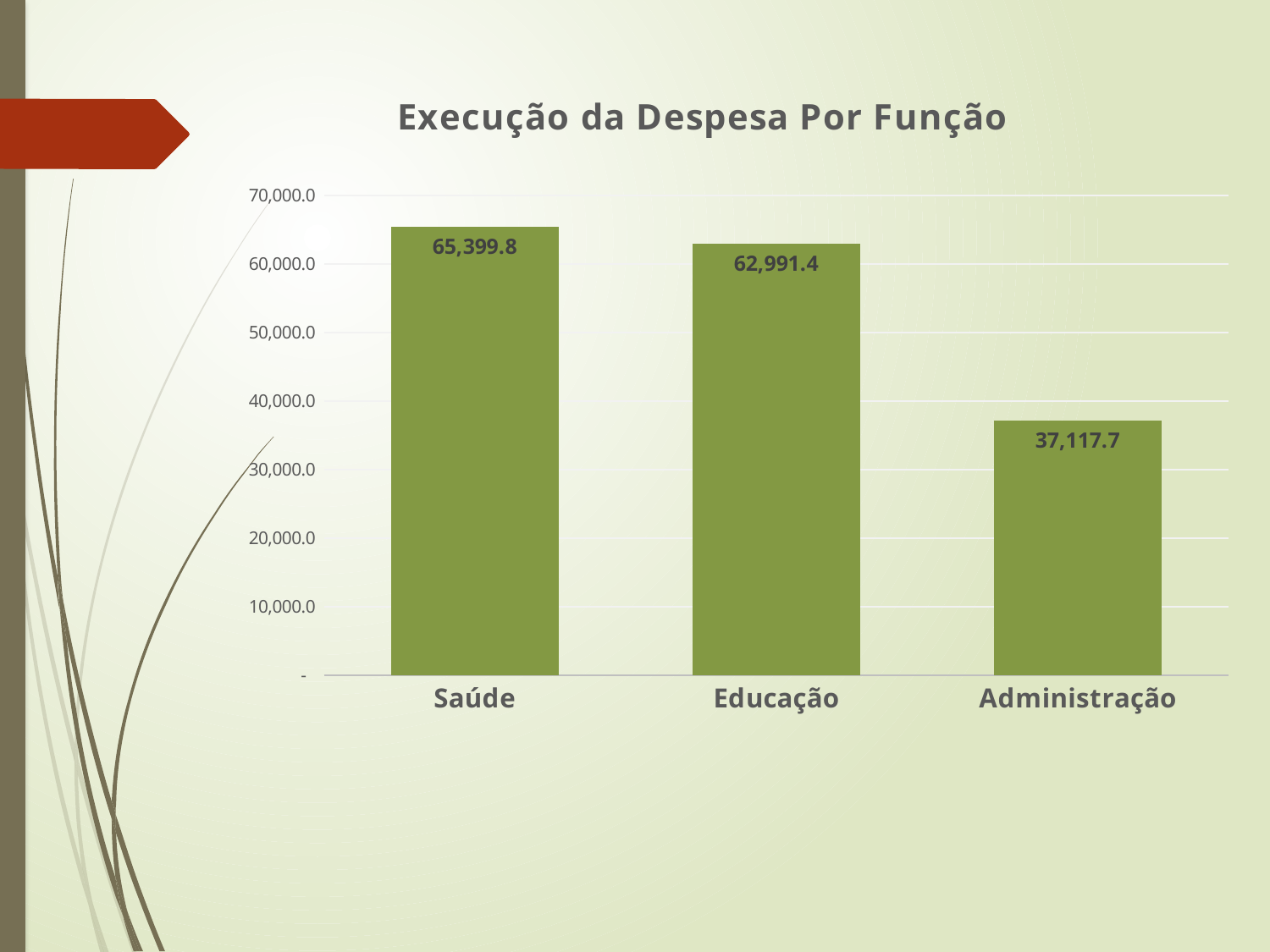
Which category has the lowest value? Administração What is the title of the chart? Execução da Despesa Por Função What is the value for Administração? 37,117.7 What is the difference between the values for Educação and Administração? 25,873.7 Which is larger, the value for Educação or the value for Administração? Educação How many categories are shown in the chart? 3 What is the value for Educação? 62,991.4 What is the value for Saúde? 65,399.8 Which category has the highest value? Saúde What is the difference between the values for Saúde and Administração? 28,282.1 What kind of chart is shown on the slide? bar chart Is the value for Administração greater or less than 40,000.0? less